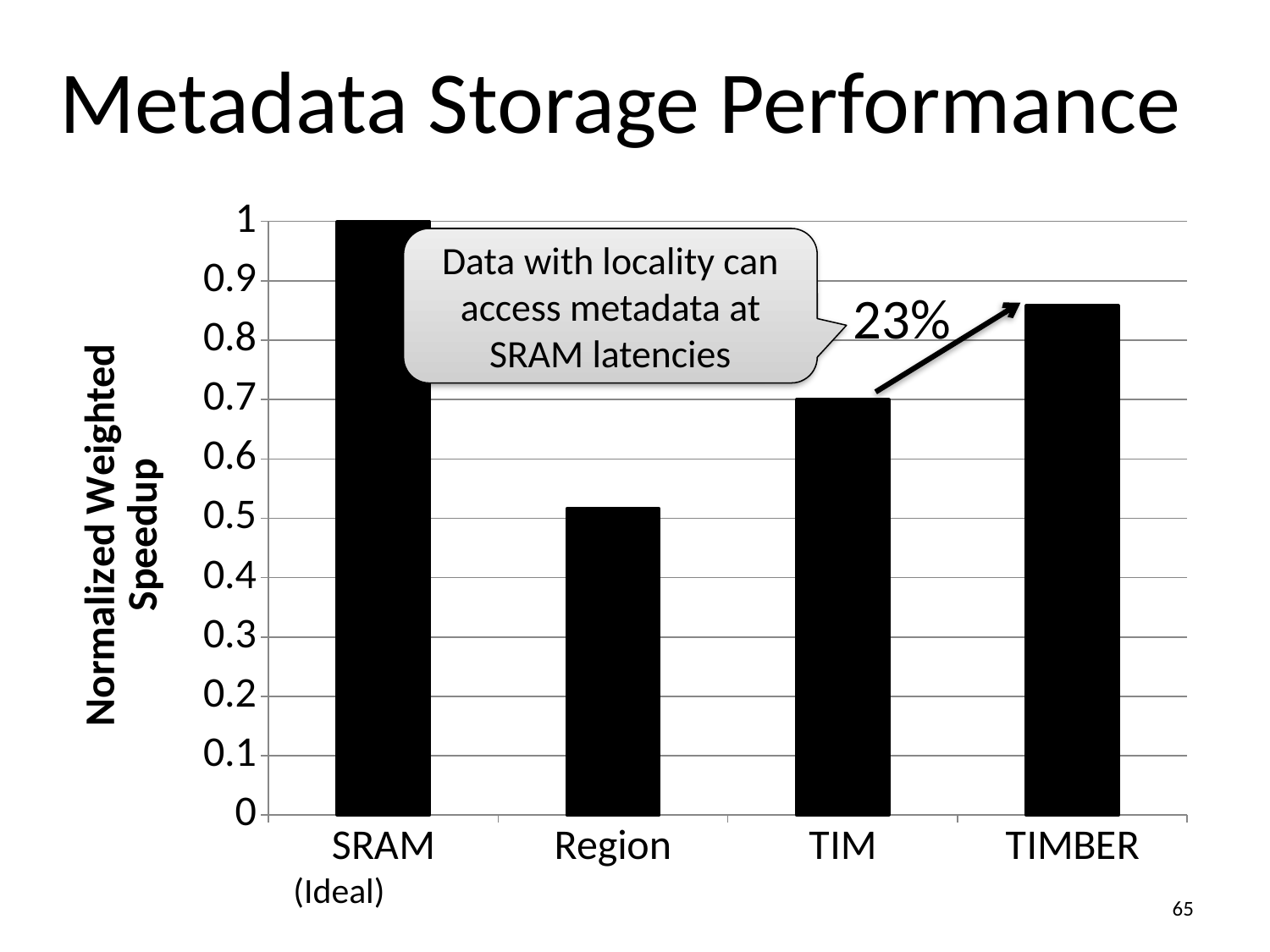
Which category has the lowest normalized weighted speedup? Region Is the value for TIMBER greater or less than 0.8? greater What is the label of the y axis? Normalized Weighted Speedup Which has a higher normalized weighted speedup, TIM or TIMBER? TIMBER What kind of chart is shown on the slide? bar chart Is the value for Region greater or less than 0.6? less How many categories are plotted on the x axis? 4 What is the normalized weighted speedup for SRAM (Ideal)? 1 Which has a higher normalized weighted speedup, Region or TIM? TIM Is the value for TIM greater or less than 0.6? greater Which category has the highest normalized weighted speedup? SRAM (Ideal) What percentage improvement is annotated between TIM and TIMBER? 23%